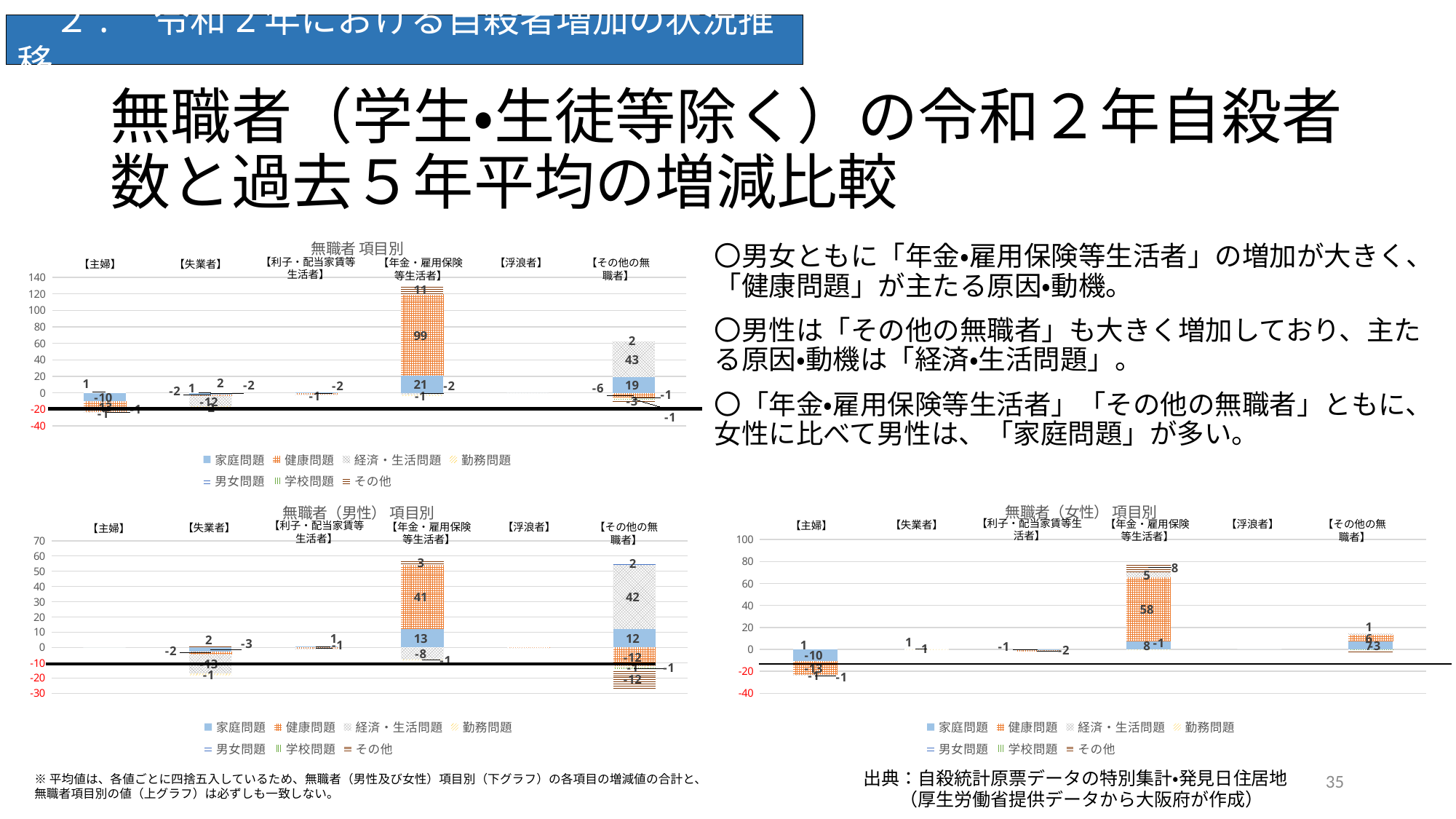
In the chart titled 無職者（男性）項目別, what is the value of 健康問題 for 【年金・雇用保険等生活者】? 41 In the chart titled 無職者（男性）項目別, what is the value of 経済・生活問題 for 【その他の無職者】? 42 In the chart titled 無職者 項目別, which category has the largest 健康問題 value? 【年金・雇用保険等生活者】 In the chart titled 無職者（男性）項目別, what is the value of 家庭問題 for 【年金・雇用保険等生活者】? 13 In the chart titled 無職者 項目別, what is the value of 家庭問題 for 【年金・雇用保険等生活者】? 21 In the chart titled 無職者（女性）項目別, what is the value of 健康問題 for 【年金・雇用保険等生活者】? 58 How many categories are shown on the x axis of the chart titled 無職者（男性）項目別? 6 In the chart titled 無職者 項目別, what is the difference between the 健康問題 value for 【年金・雇用保険等生活者】 and the 経済・生活問題 value for 【その他の無職者】? 56 How many series does the legend of the chart titled 無職者（女性）項目別 list? 7 In the chart titled 無職者 項目別, what is the value of 経済・生活問題 for 【その他の無職者】? 43 In the chart titled 無職者 項目別, what is the value of 健康問題 for 【年金・雇用保険等生活者】? 99 In the chart titled 無職者（女性）項目別, is the top of the stacked bar for 【年金・雇用保険等生活者】 greater or less than 60? greater